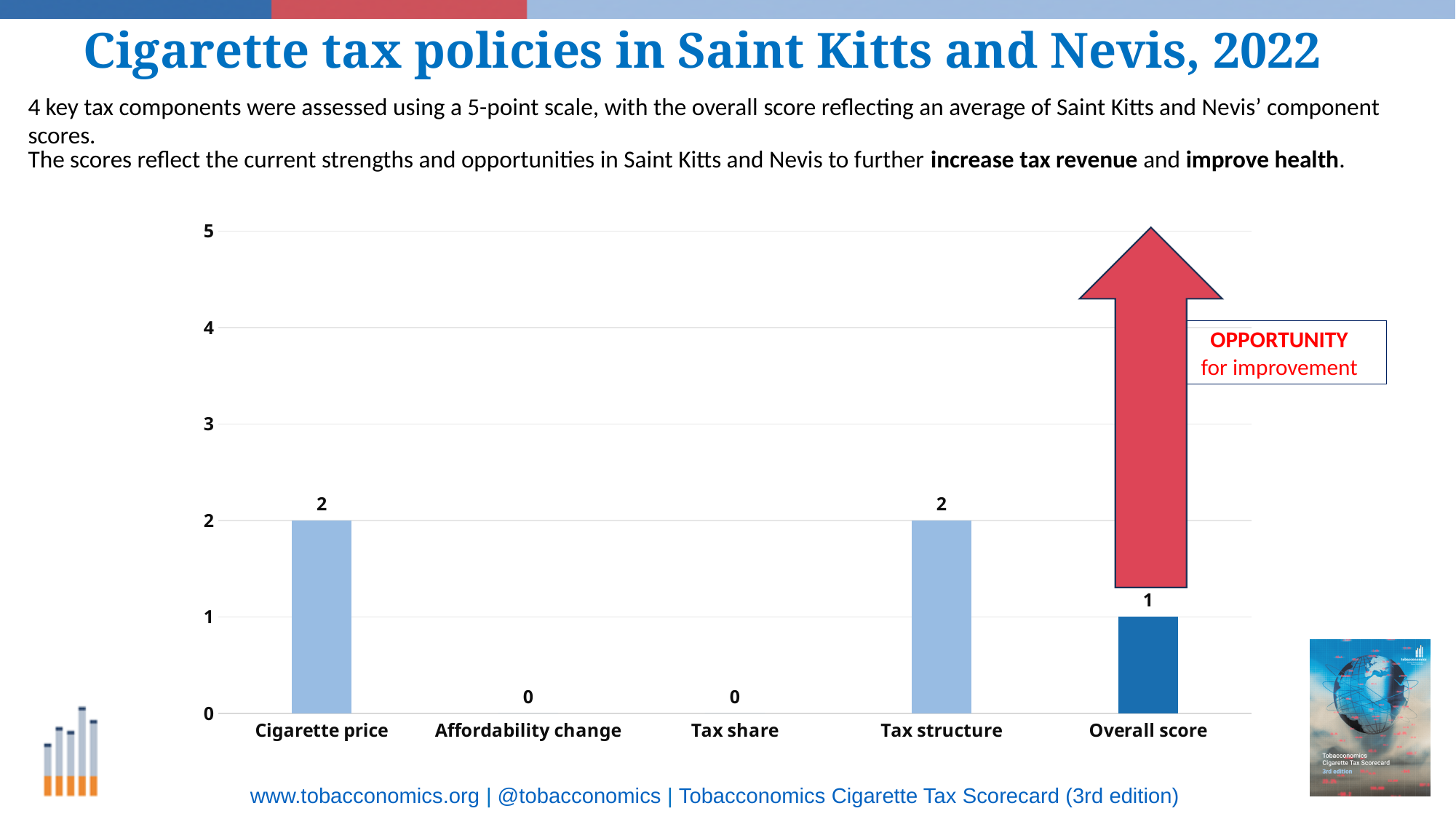
How many categories are shown on the x axis of the chart? 5 What is the value for Tax structure? 2 What is the value for Cigarette price? 2 What kind of chart is shown on the slide? bar chart What is the value for Affordability change? 0 What is the difference between the value for Cigarette price and the Overall score? 1 Which is larger, the value for Tax structure or the Overall score? Tax structure What text appears in the box next to the red arrow on the chart? OPPORTUNITY for improvement What is the Overall score? 1 Is the value for Tax structure greater or less than 3? less What is the maximum value shown on the y axis of the chart? 5 What is the value for Tax share? 0